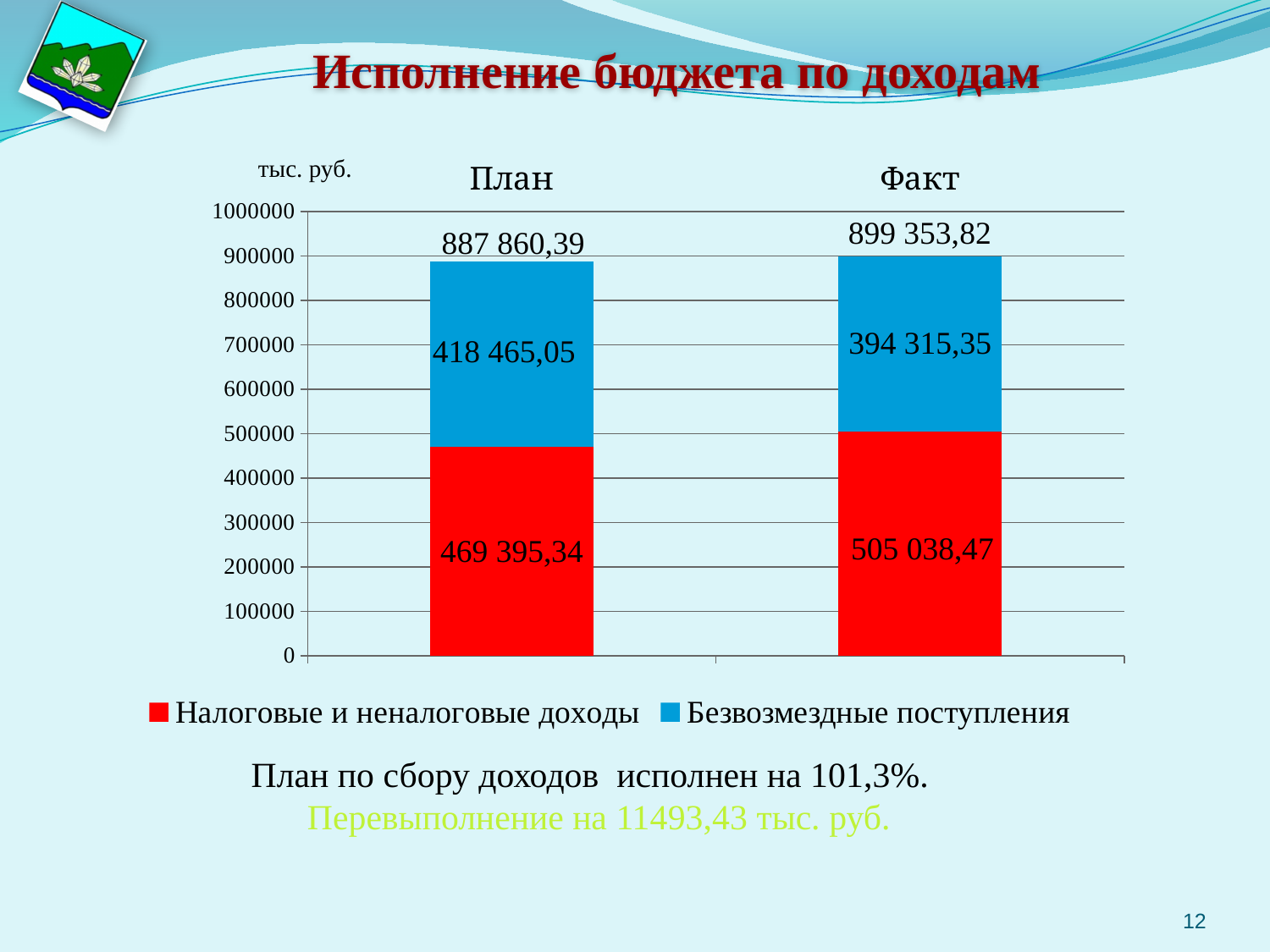
What type of chart is shown on the slide? Stacked bar chart How many categories are shown on the x axis? 2 Which category has the lower value for Безвозмездные поступления? Факт What is the difference between the total for Факт and the total for План? 11 493,43 What is the difference between the Налоговые и неналоговые доходы values for Факт and План? 35 643,13 Which colour represents Безвозмездные поступления in the chart? Blue Which category has the higher value for Налоговые и неналоговые доходы, План or Факт? Факт What is the total of the stacked bar for Факт? 899 353,82 What is the value of Безвозмездные поступления for Факт? 394 315,35 How many series does the legend list? 2 What is the total of the stacked bar for План? 887 860,39 What is the value of Налоговые и неналоговые доходы for План? 469 395,34